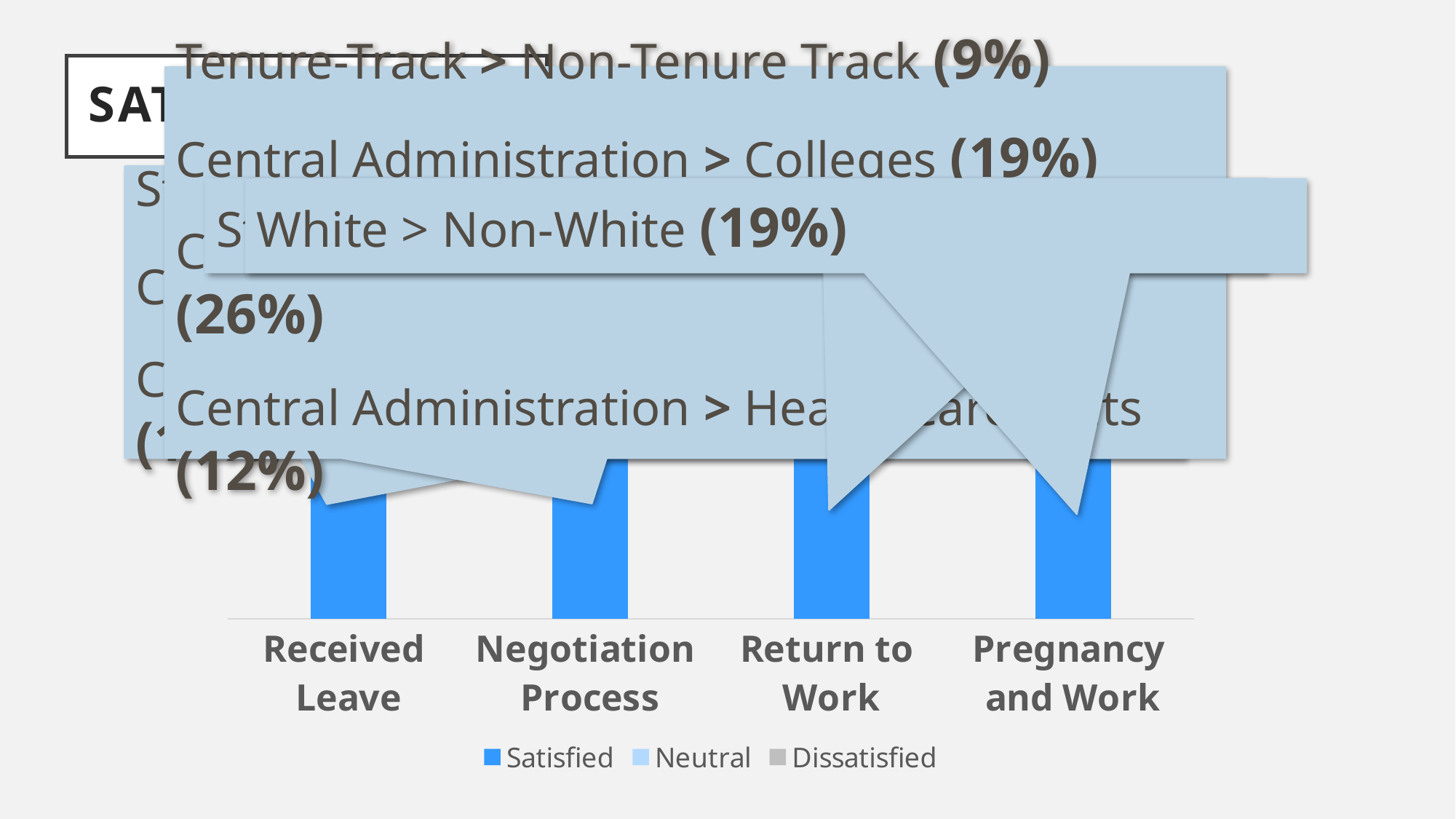
What are the names of the series listed in the chart's legend? Satisfied, Neutral, Dissatisfied Which category appears between Negotiation Process and Pregnancy and Work on the x axis? Return to Work What is the label of the last category on the x axis of the chart? Pregnancy and Work How many categories are shown on the x axis of the chart? 4 What kind of chart is shown on the slide? bar chart Which series in the legend is shown in dark blue? Satisfied What is the label of the first category on the x axis of the chart? Received Leave How many series does the chart's legend list? 3